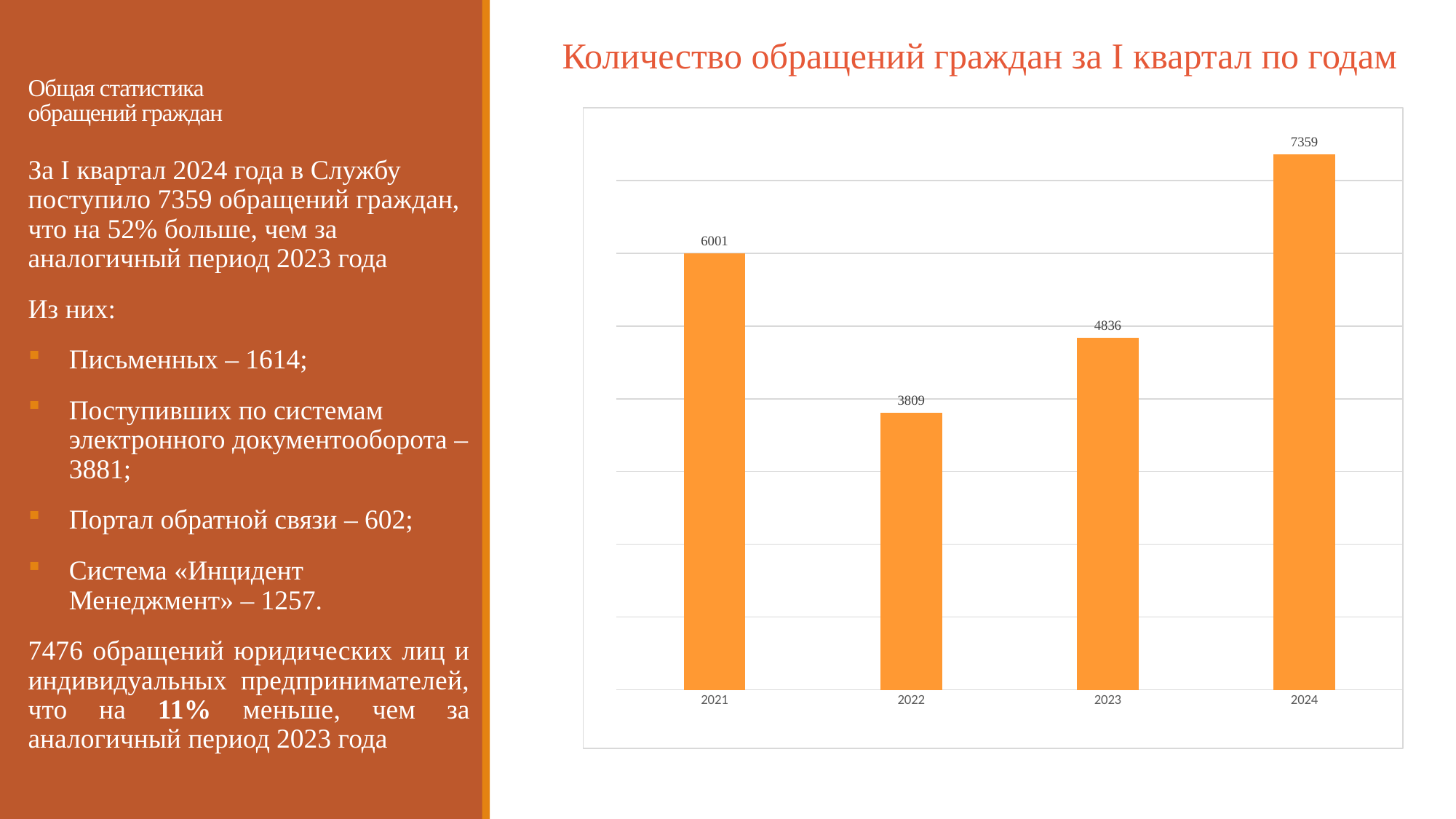
What is the value for 2022? 3809 How many years are shown on the chart? 4 What is the difference between the values for 2024 and 2023? 2523 What kind of chart is this? bar chart What is the title of the chart? Количество обращений граждан за I квартал по годам What is the difference between the values for 2021 and 2022? 2192 Which year has the lowest value? 2022 What is the value for 2023? 4836 Which year has the highest value? 2024 Which is larger, the value for 2021 or the value for 2023? 2021 What is the value for 2021? 6001 What is the value for 2024? 7359